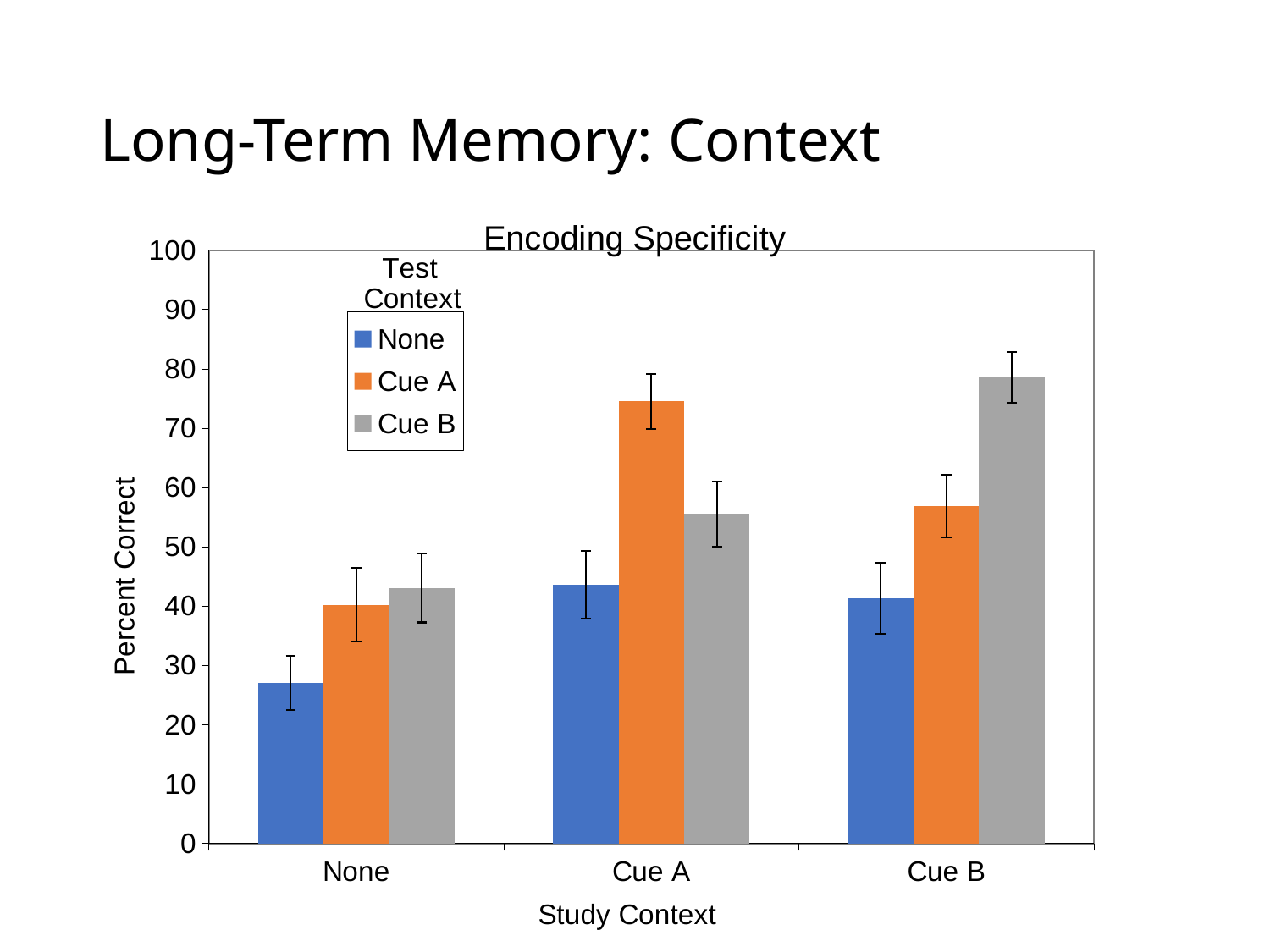
Within the Cue B study context, which test context has the highest percent correct? Cue B How many study context categories are shown on the x axis? 3 Which test context series is shown in orange? Cue A What kind of chart is shown on the slide? bar chart Is the percent correct for the Cue B test context in the Cue A study context greater or less than 50? greater Which bar on the chart has the lowest percent correct? None study context, None test context What is the title of the chart? Encoding Specificity Is the percent correct for the Cue A test context in the Cue A study context greater or less than 70? greater In the Cue B study context, which is larger: the percent correct for the Cue B test context or the None test context? Cue B Within the Cue A study context, which test context has the highest percent correct? Cue A How many series does the legend list? 3 Is the percent correct for the None test context in the None study context greater or less than 30? less